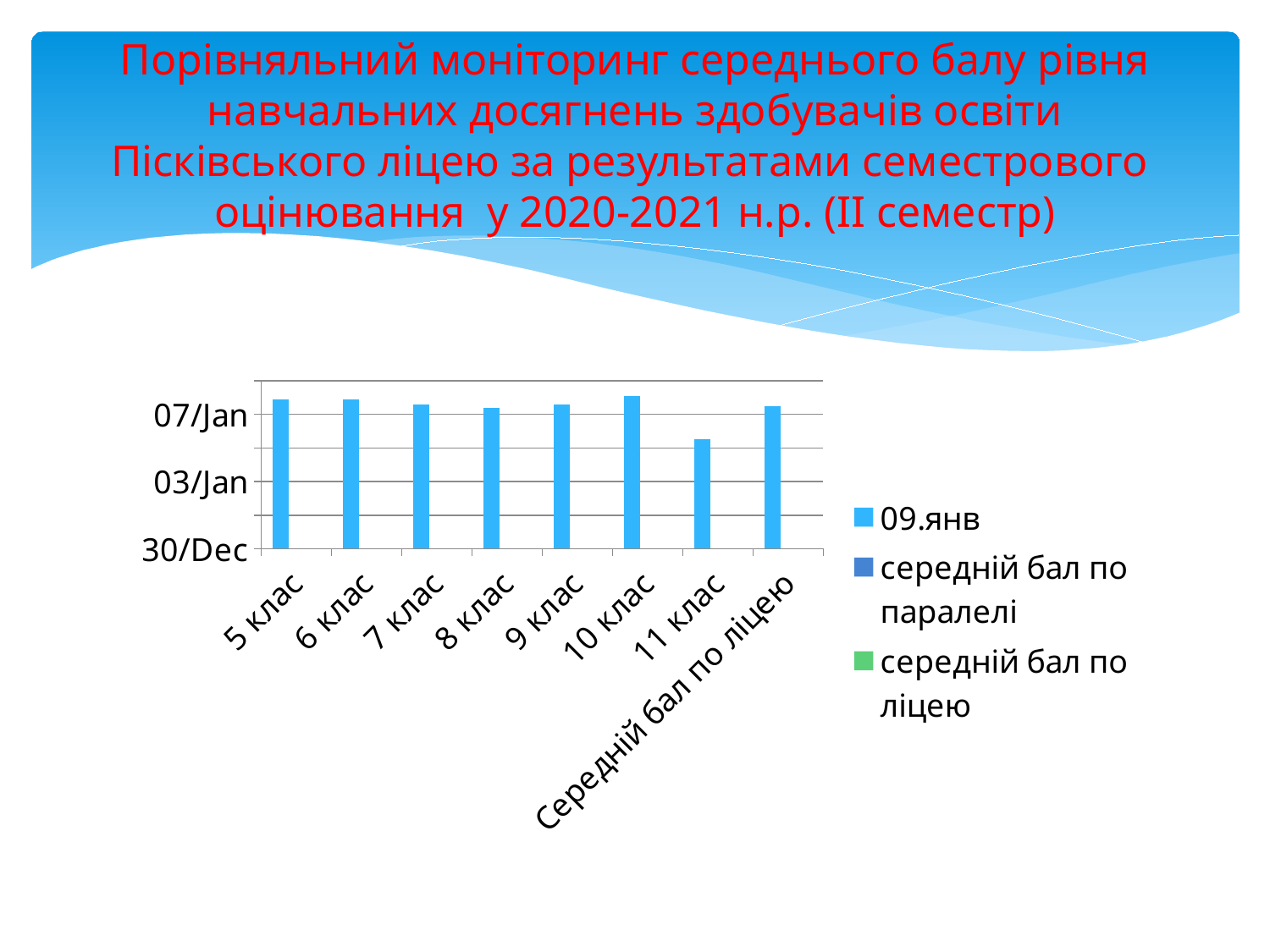
What is the label of the last category on the x axis of the chart? Середній бал по ліцею What kind of chart is shown on the slide? bar chart How many series does the chart's legend list? 3 What is the last entry listed in the chart's legend? середній бал по ліцею Which bar is taller, 5 клас or 11 клас? 5 клас Which bar is taller, 11 клас or Середній бал по ліцею? Середній бал по ліцею Which category has the lowest bar in the chart? 11 клас Which bar is taller, 10 клас or 11 клас? 10 клас How many categories are shown along the x axis of the chart? 8 What is the first entry listed in the chart's legend? 09.янв Which category has the highest bar in the chart? 10 клас